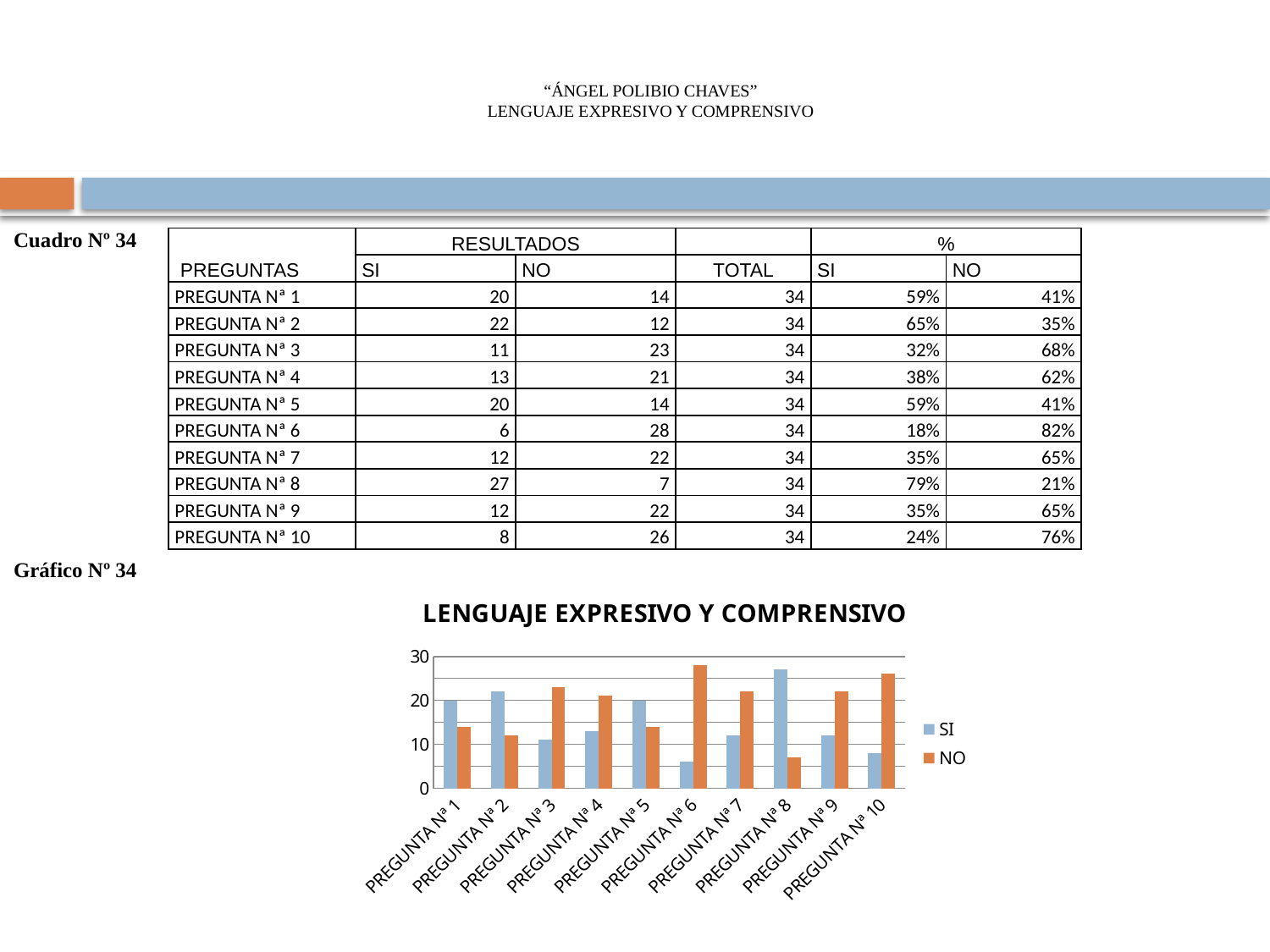
What is the title of the chart? LENGUAJE EXPRESIVO Y COMPRENSIVO What kind of chart is shown on the slide? bar chart Which pregunta has the highest SI value in the chart? PREGUNTA Nª 8 What is the SI value for PREGUNTA Nª 1 according to the table on the slide? 20 Which pregunta has the lowest NO value in the chart? PREGUNTA Nª 8 Which pregunta has the highest NO value in the chart? PREGUNTA Nª 6 How many categories (preguntas) are shown on the x axis of the chart? 10 For PREGUNTA Nª 3, which is larger, the SI value or the NO value? NO Is the NO value for PREGUNTA Nª 2 greater or less than 20? less Which pregunta has the lowest SI value in the chart? PREGUNTA Nª 6 Is the SI value for PREGUNTA Nª 8 greater or less than 20? greater How many series does the chart legend list? 2